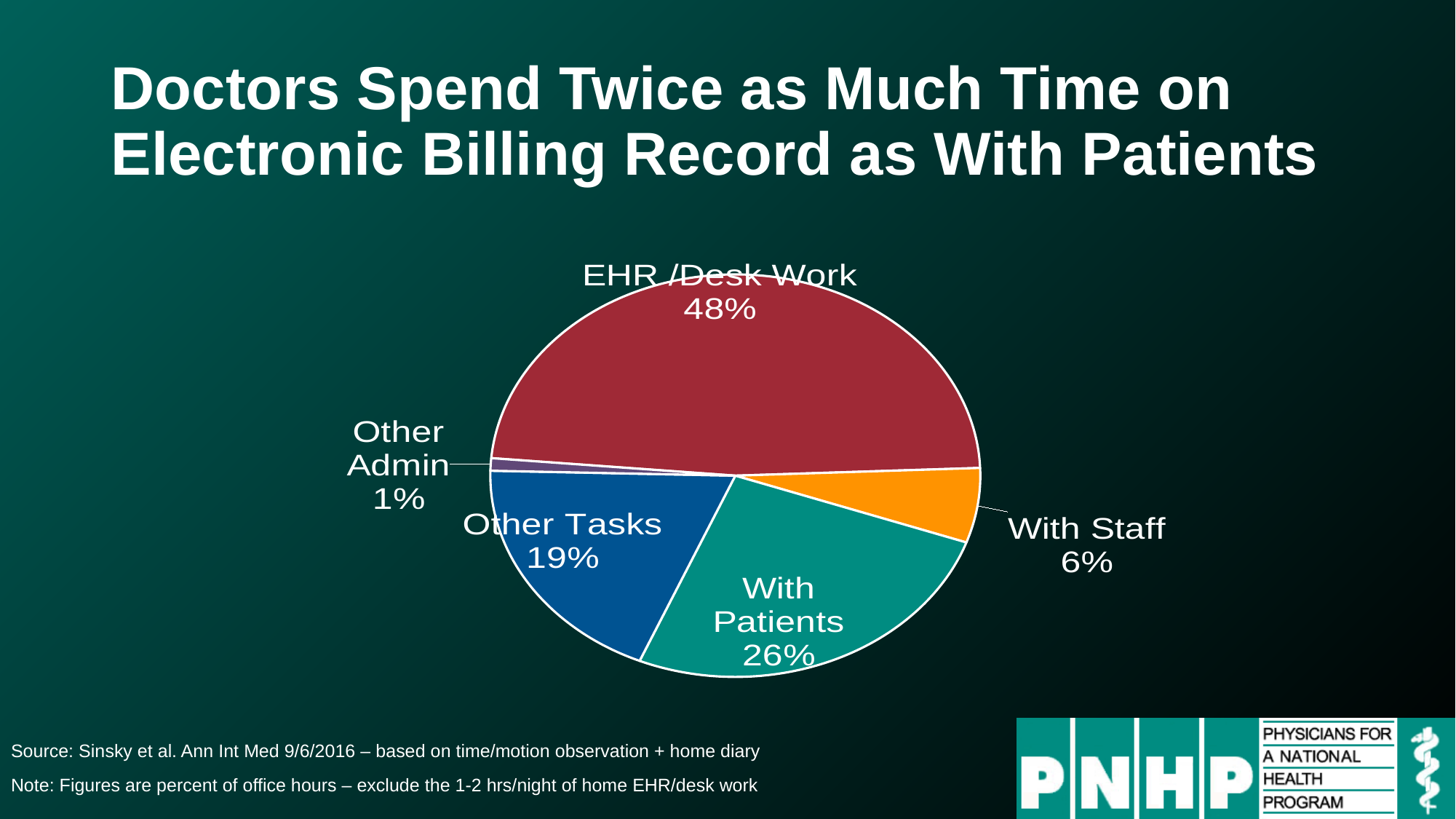
What percentage of office hours do doctors spend on EHR / Desk Work? 48% What kind of chart is shown on the slide? Pie chart What percentage of office hours is spent With Staff? 6% What colour is the With Patients slice? Teal How many slices does the pie chart have? 5 What percentage of office hours do doctors spend With Patients? 26% What percentage of office hours is spent on Other Tasks? 19% Which is larger, the share for Other Tasks or the share for With Staff? Other Tasks Which category takes the smallest share of the pie? Other Admin What percentage of office hours is spent on Other Admin? 1% Which category takes the largest share of the pie? EHR / Desk Work How many percentage points larger is EHR / Desk Work than With Patients? 22